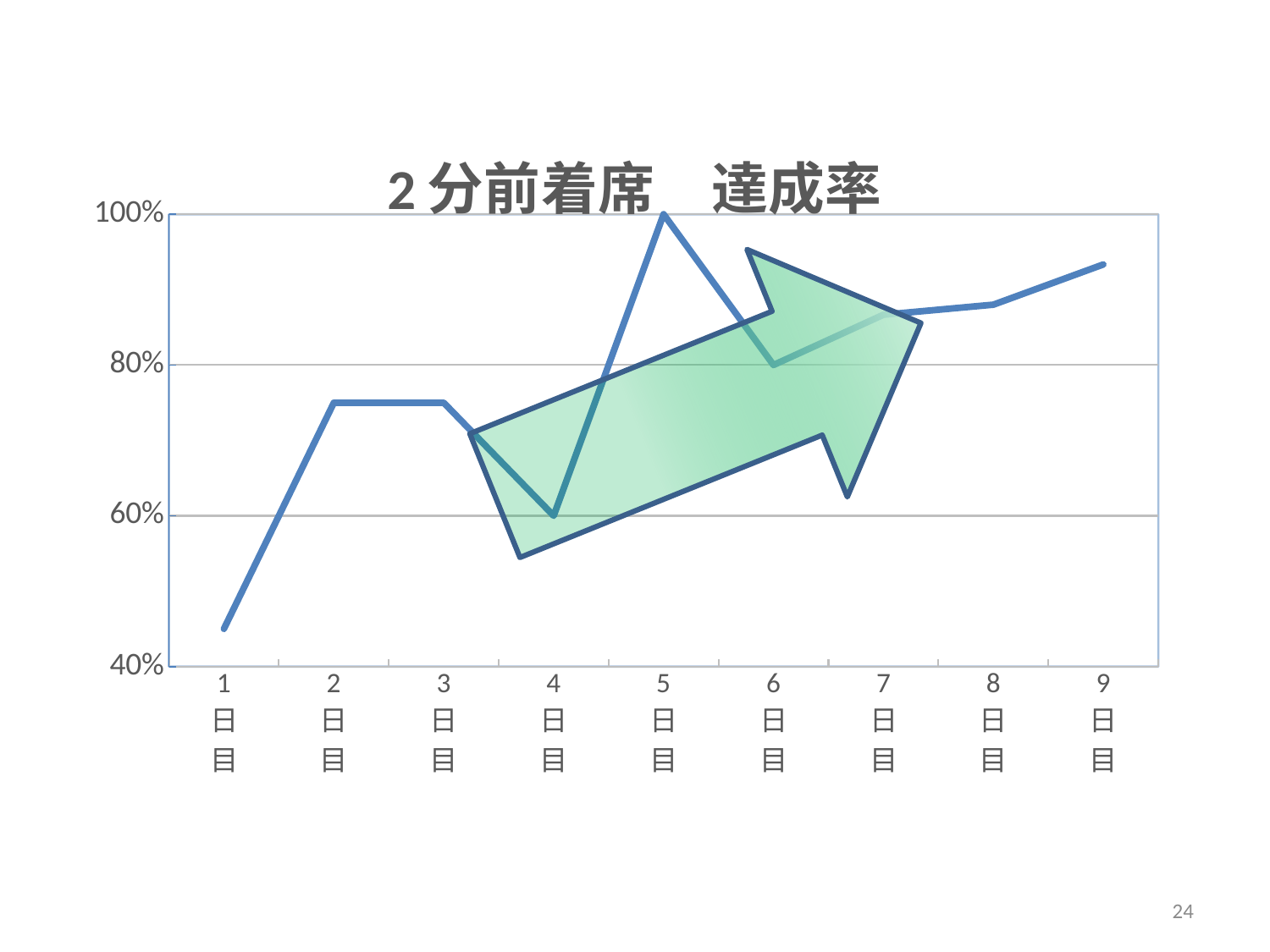
Is the value for 2日目 greater or less than 80%? less From 7日目 to 9日目, does the achievement rate rise or fall? rise Is the value for 1日目 greater or less than 60%? less Is the value for 8日目 greater or less than 80%? greater How many days (points) are plotted along the x axis? 9 On which day is the achievement rate highest? 5日目 What is the achievement rate on 5日目? 100% What is the title of the chart? 2分前着席 達成率 On which day is the achievement rate lowest? 1日目 Which has the higher achievement rate, 7日目 or 9日目? 9日目 What kind of chart is shown on the slide? line chart